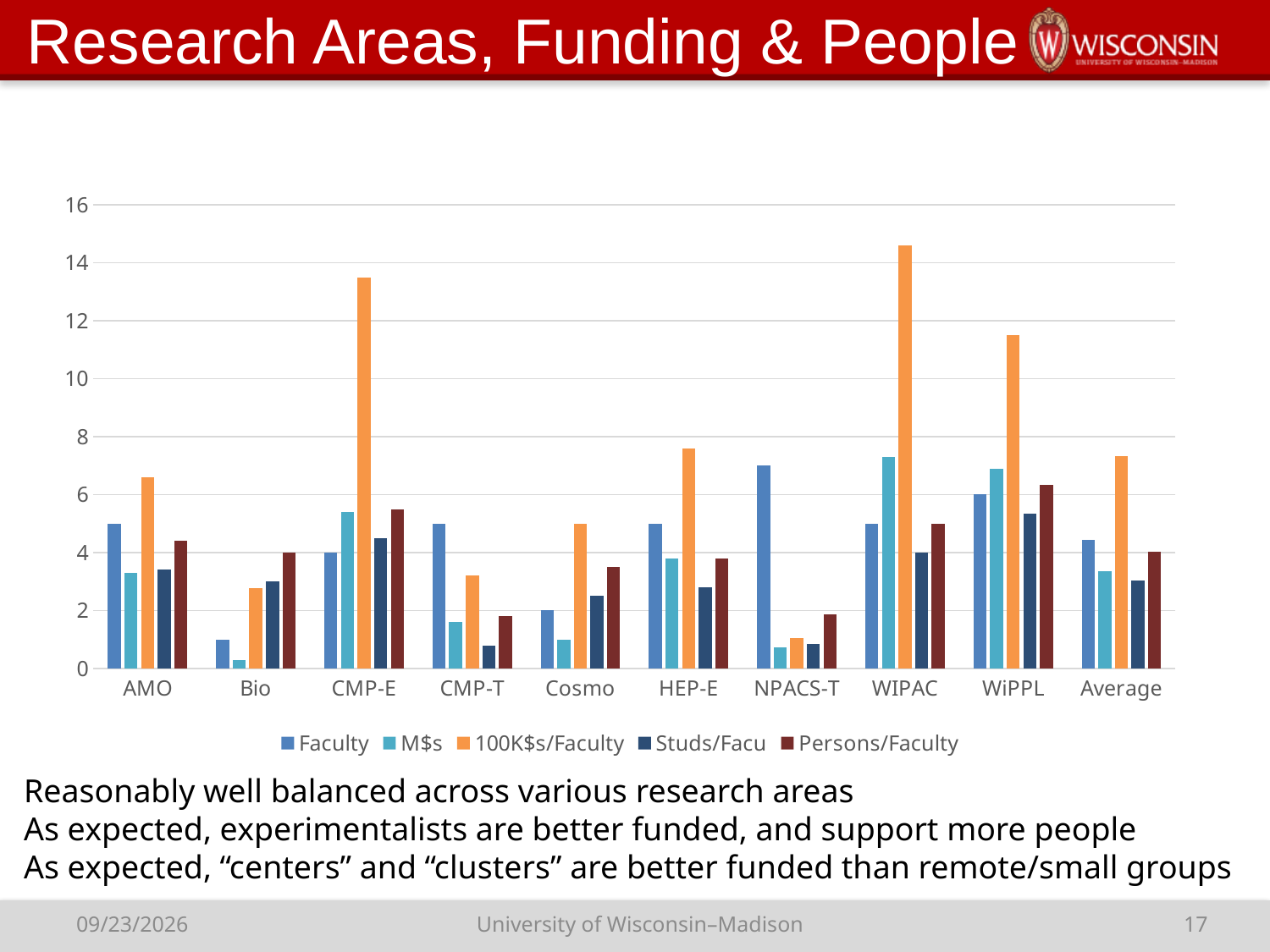
Is the 100K$s/Faculty value for CMP-E greater or less than 12? greater Which series is shown in orange in the chart's legend? 100K$s/Faculty Which category has the lowest 100K$s/Faculty value? NPACS-T Is the M$s value for Bio greater or less than 2? less Which category has the highest Faculty value? NPACS-T Which category has the lowest Faculty value? Bio Which category has the highest 100K$s/Faculty value? WIPAC Which category has the lowest M$s value? Bio How many series does the chart's legend list? 5 What kind of chart is shown on the slide? bar chart How many research-area categories are shown on the x axis of the chart? 10 Which is larger, the 100K$s/Faculty value for CMP-E or for HEP-E? CMP-E